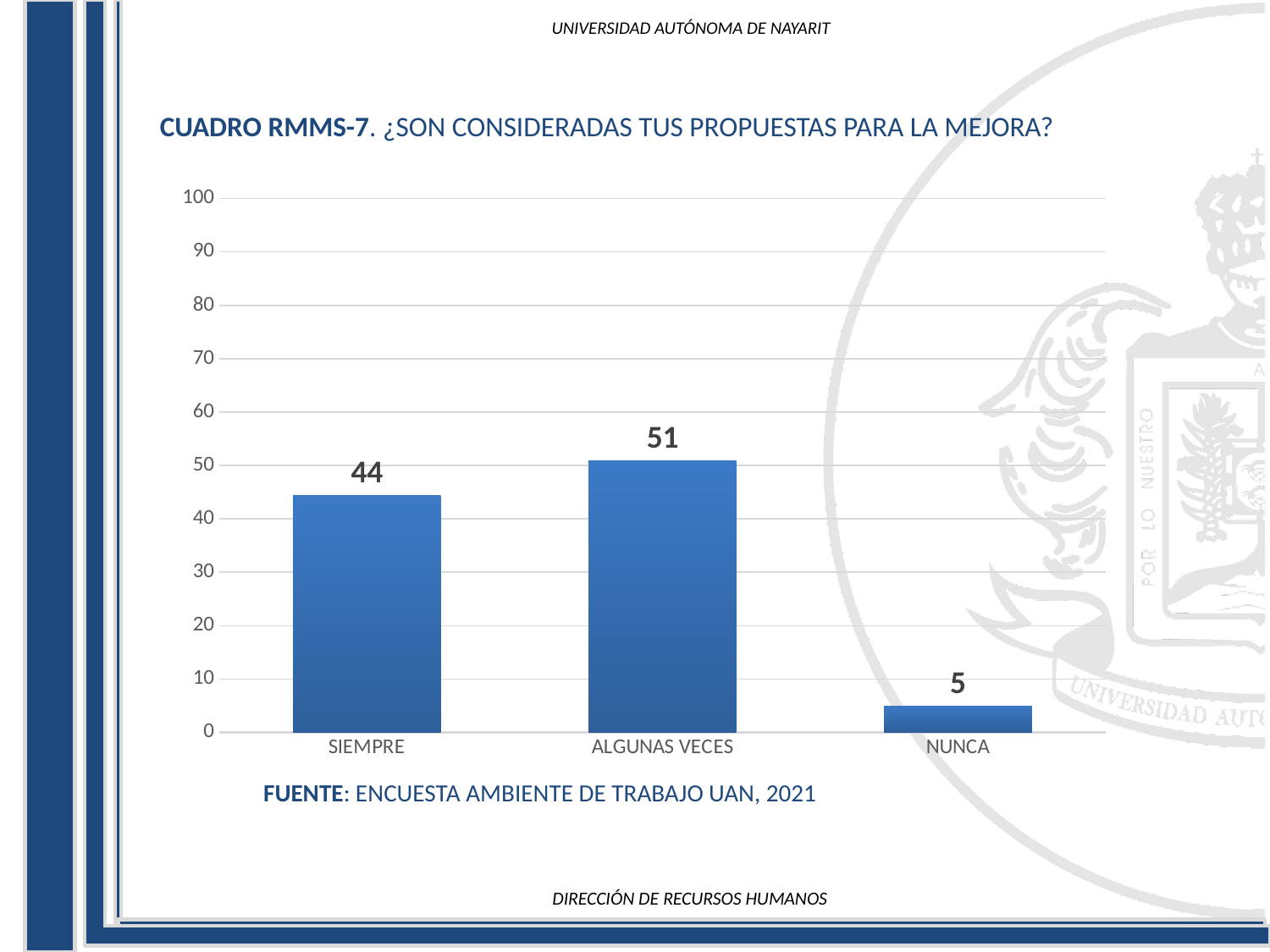
Which is larger, the value for SIEMPRE or the value for NUNCA? SIEMPRE What kind of chart is shown on the slide? bar chart What source is cited below the chart? ENCUESTA AMBIENTE DE TRABAJO UAN, 2021 What is the value for SIEMPRE? 44 What is the value for NUNCA? 5 What is the total of the three values shown in the chart? 100 What is the value for ALGUNAS VECES? 51 How many categories are shown on the x axis? 3 Which category has the highest value? ALGUNAS VECES Which category has the lowest value? NUNCA Is the value for SIEMPRE greater or less than 50? less What is the difference between the values for ALGUNAS VECES and SIEMPRE? 7